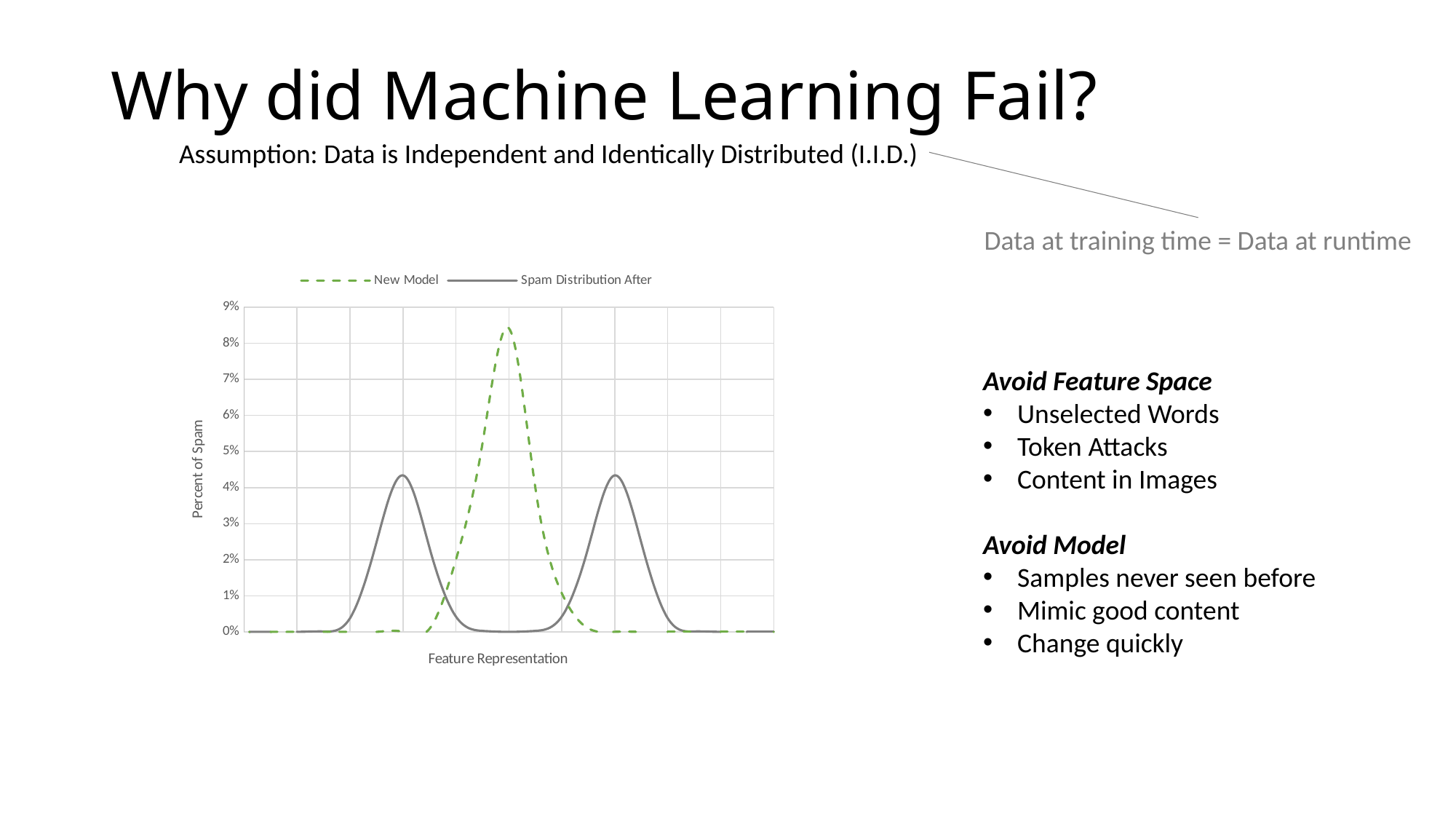
Is the value of the New Model line at the centre of the x axis greater or less than 7%? greater Is the peak value of the Spam Distribution After line greater or less than 4%? greater Is the peak value of the New Model line greater or less than 8%? greater How many series does the chart's legend list? 2 How many peaks does the Spam Distribution After line have? 2 What kind of chart is shown on the slide? line chart What is the title of the chart's vertical axis? Percent of Spam How many peaks does the New Model line have? 1 Which series reaches a higher peak, New Model or Spam Distribution After? New Model What are the two series named in the chart's legend? New Model and Spam Distribution After What is the highest value labelled on the chart's vertical axis? 9%